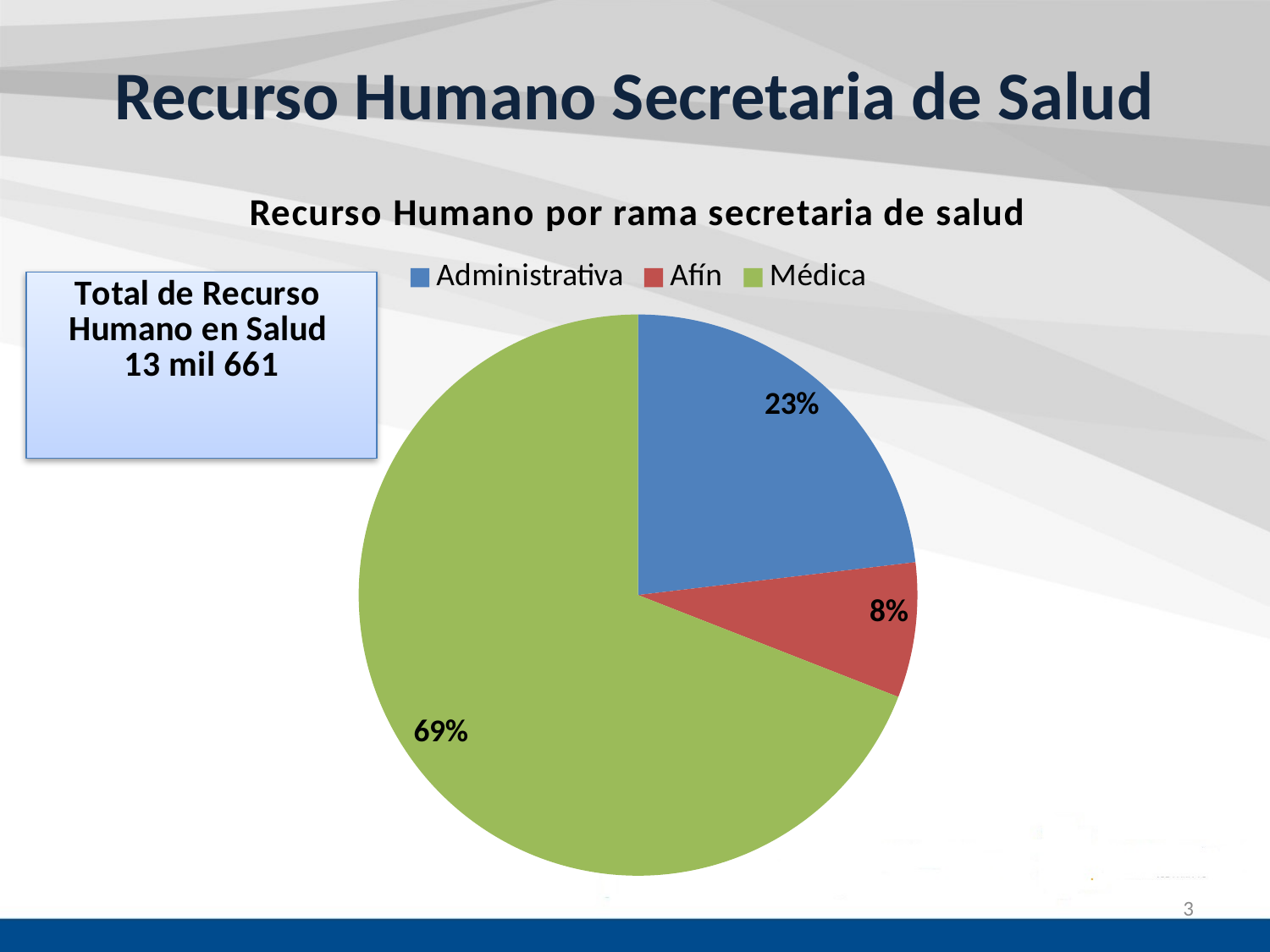
What colour is the Médica slice? green What share of the pie does Médica represent? 69% How many categories does the legend list? 3 Which is larger, the Administrativa slice or the Afín slice? Administrativa What is the title of the chart? Recurso Humano por rama secretaria de salud What share of the pie does Administrativa represent? 23% Which category has the smallest slice? Afín What is the difference in percentage points between the Médica and Administrativa slices? 46 What is the difference in percentage points between the Administrativa and Afín slices? 15 What type of chart is shown on the slide? pie chart Which category has the largest slice? Médica What share of the pie does Afín represent? 8%